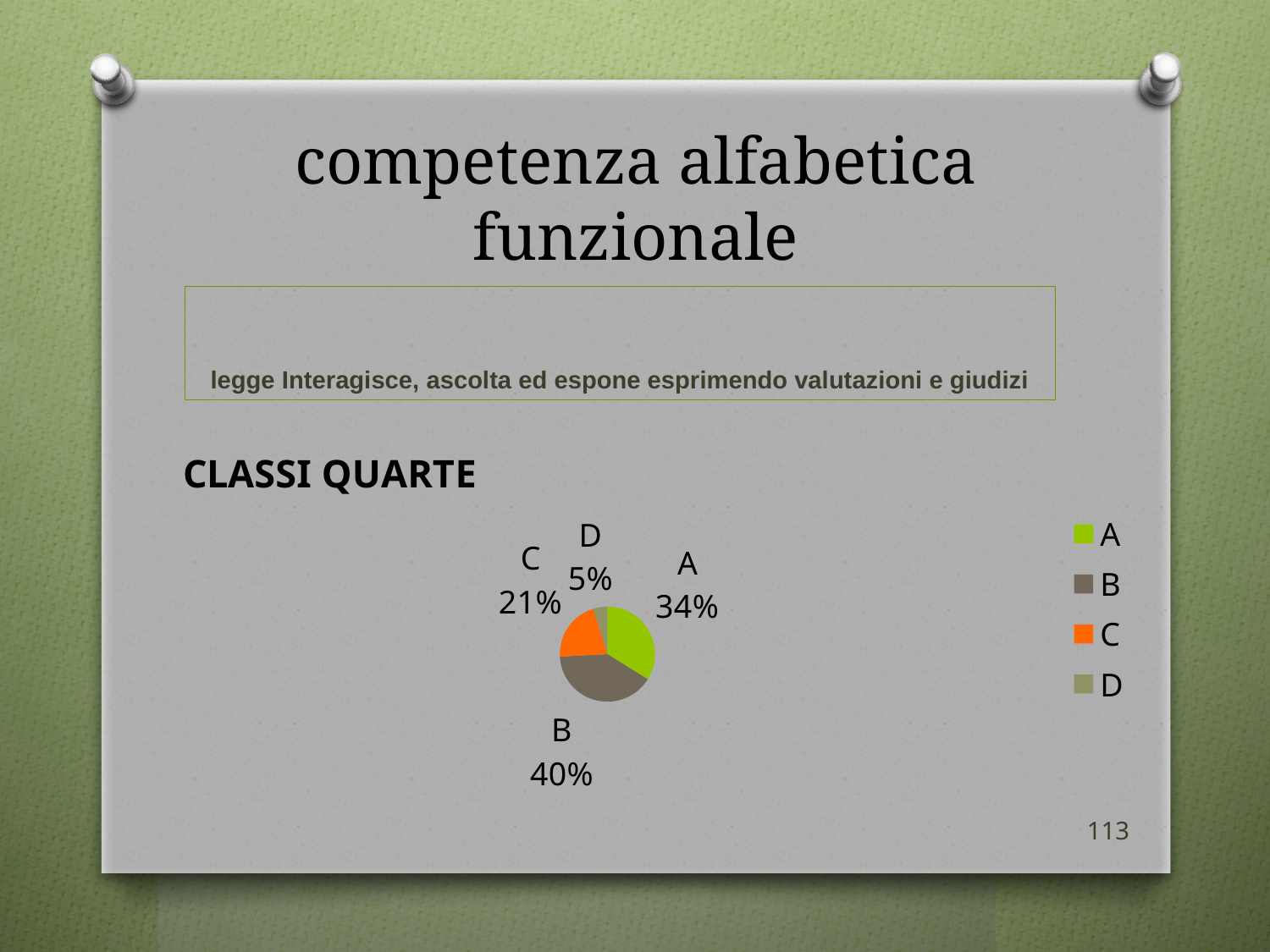
What is the difference in percentage points between the shares of C and D? 16 What share of the pie does category C have? 21% What is the difference in percentage points between the shares of B and A? 6 Which has a larger share, A or C? A Which colour represents category C in the legend? orange Which category has the smallest share of the pie? D How many slices does the pie chart have? 4 What kind of chart is shown on the slide? pie chart What share of the pie does category D have? 5% What share of the pie does category B have? 40% What share of the pie does category A have? 34% Which category has the largest share of the pie? B